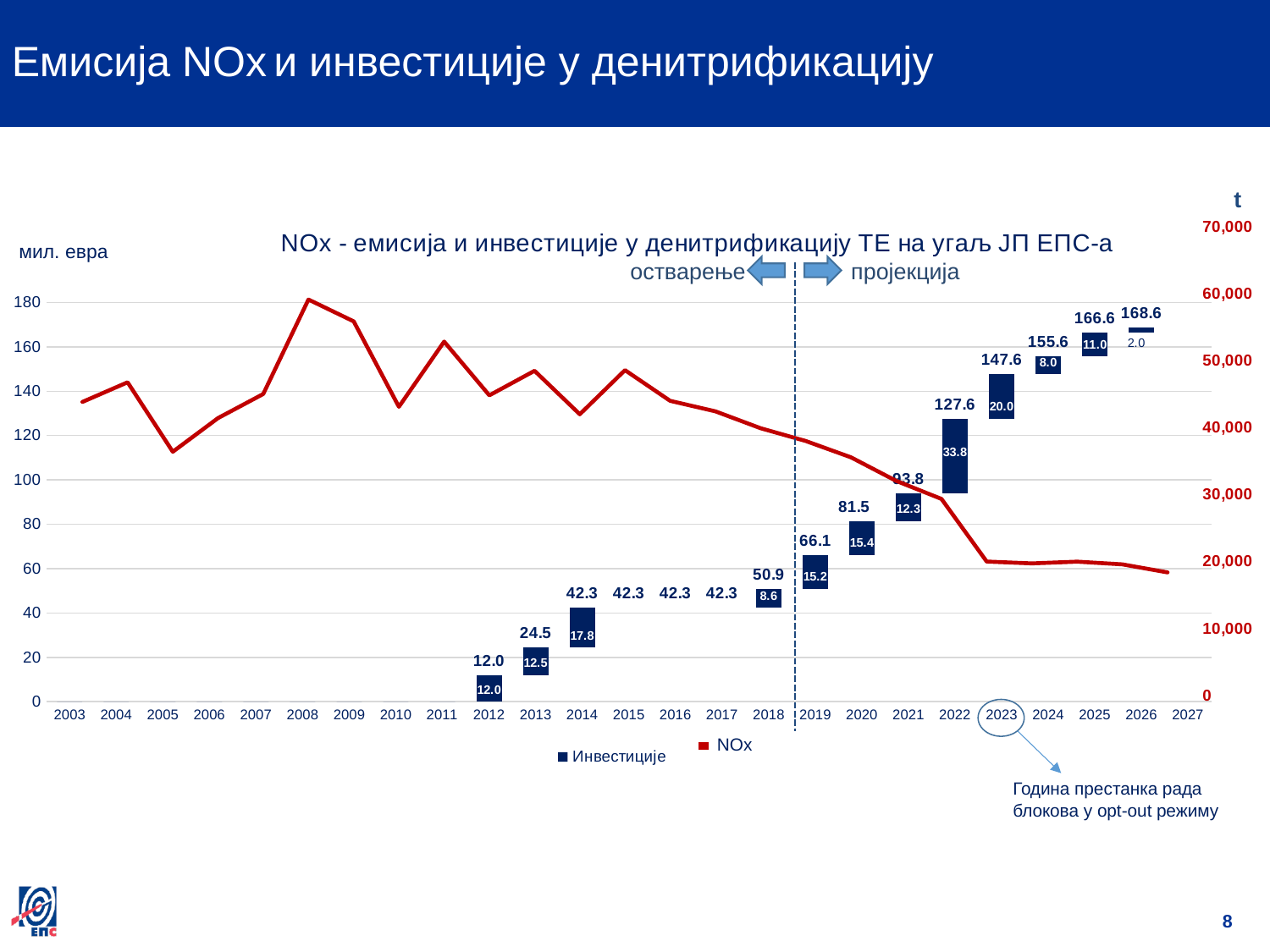
Is the NOx value for 2027 greater or less than 30,000 t? less Which year has the larger cumulative investment label, 2019 or 2020? 2020 How many series does the legend list? 2 What is the difference between the cumulative investment labels for 2023 and 2022? 20.0 What is the cumulative investment value labelled for 2017? 42.3 What value is printed inside the investment bar for 2022? 33.8 What is the cumulative investment value labelled above the bar for 2022? 127.6 In which year is the value printed inside the investment bar the smallest? 2026 In which year is the value printed inside the investment bar the largest? 2022 What is the cumulative investment value labelled for 2026? 168.6 Does the NOx line rise or fall from 2019 to 2027? fall Is the NOx value for 2008 greater or less than 50,000 t? greater